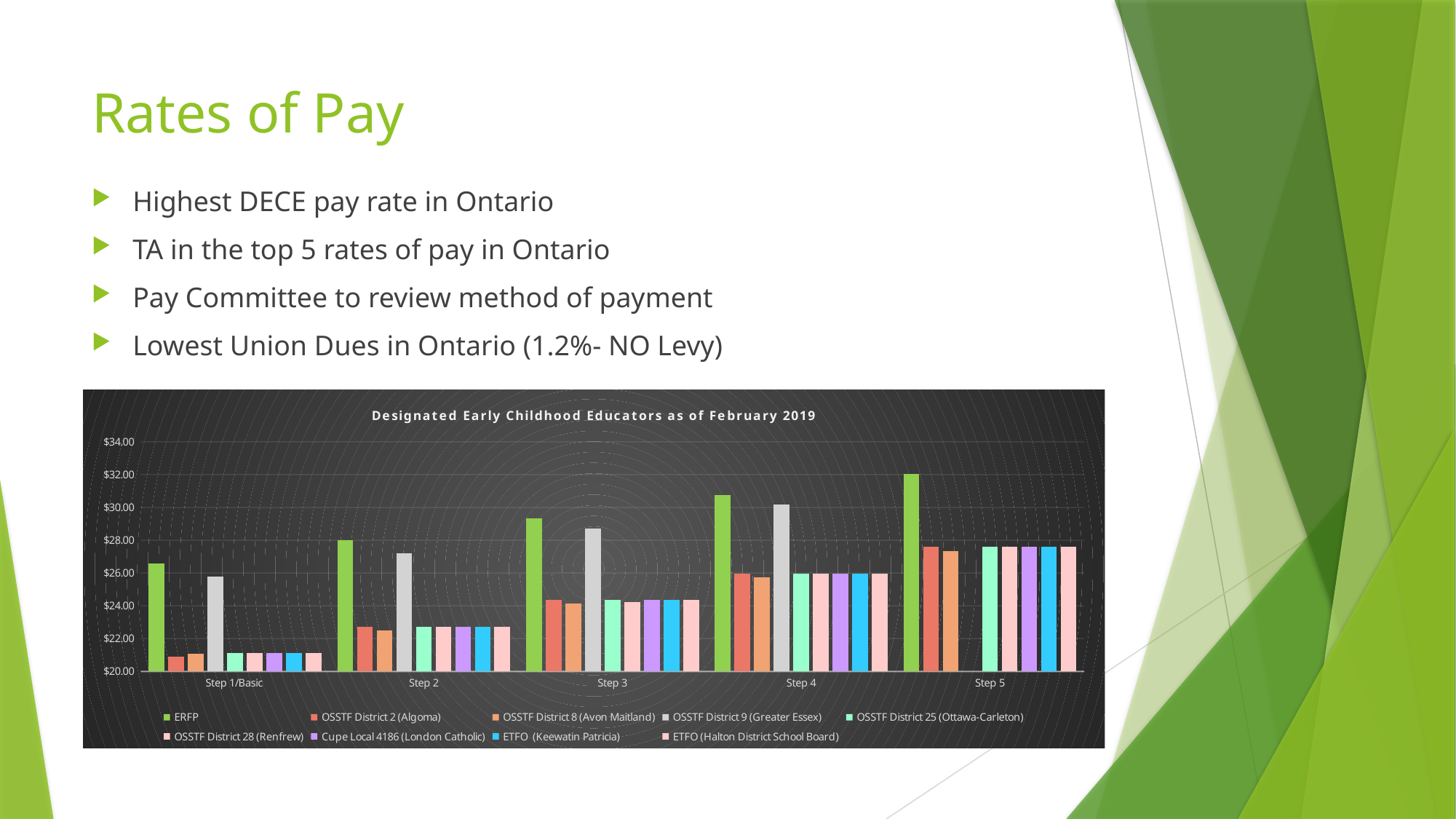
Which series has the tallest bar anywhere in the chart? ERFP Which series has the highest bar at Step 5? ERFP Is the value for ERFP at Step 4 greater or less than $30.00? greater Is the value for OSSTF District 2 (Algoma) at Step 1/Basic greater or less than $22.00? less What is the title of the chart? Designated Early Childhood Educators as of February 2019 Is the value for OSSTF District 25 (Ottawa-Carleton) at Step 5 greater or less than $28.00? less Do the ERFP values rise or fall from Step 1/Basic to Step 5? rise What kind of chart is shown on the slide? bar chart How many step categories are shown on the x axis of the chart? 5 How many series does the chart's legend list? 9 At Step 3, which is larger: the ERFP bar or the OSSTF District 9 (Greater Essex) bar? ERFP